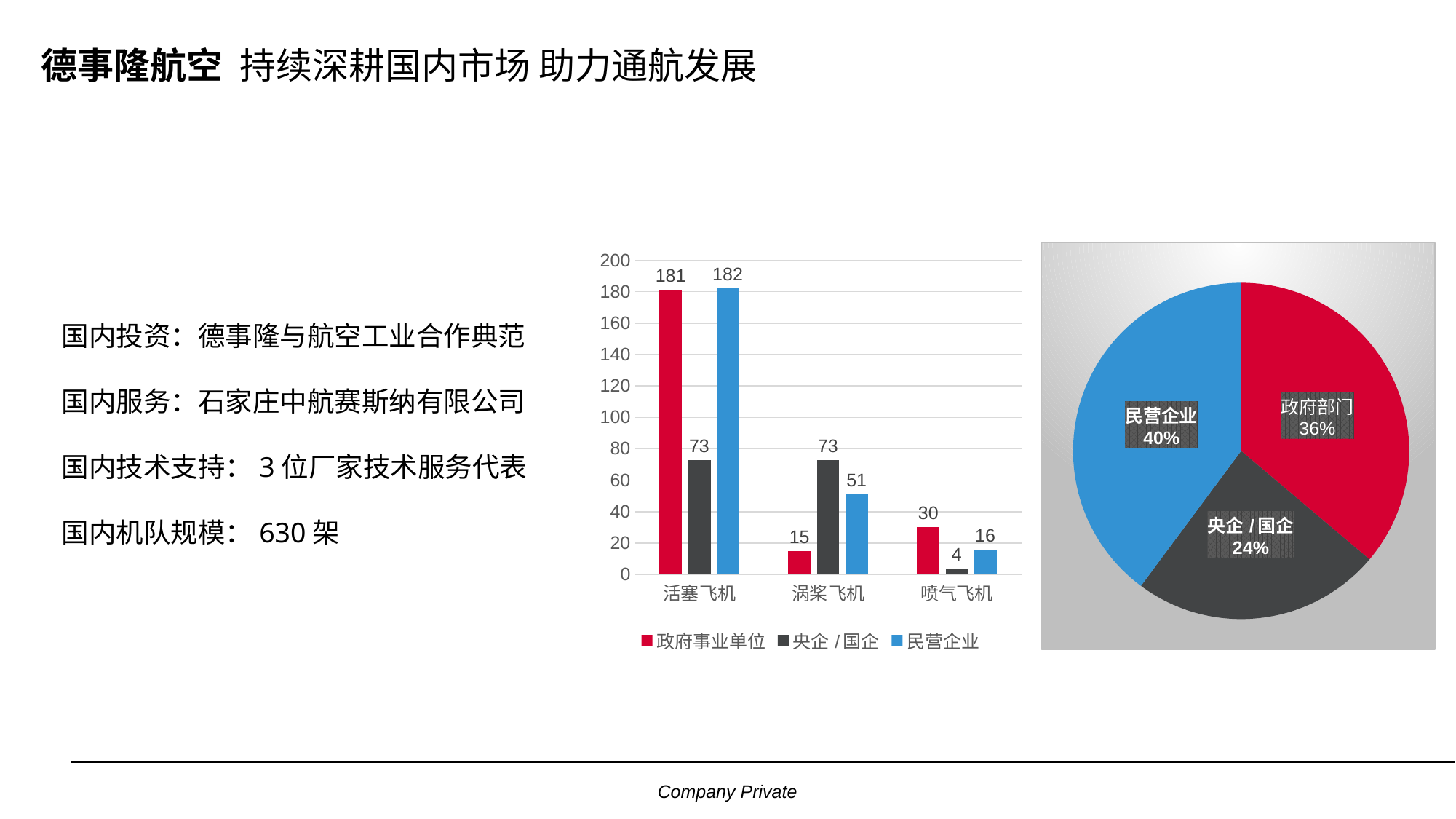
In the bar chart on the left, how many categories are shown on the x axis? 3 In the bar chart on the left, which is larger in the 涡桨飞机 category: 央企 / 国企 or 民营企业? 央企 / 国企 What kind of chart is the chart on the left? bar chart In the pie chart on the right, what colour is the 政府部门 slice? red In the bar chart on the left, what is the difference between the 民营企业 and 政府事业单位 values in the 涡桨飞机 category? 36 In the bar chart on the left, what is the value for 政府事业单位 in the 喷气飞机 category? 30 In the pie chart on the right, what share does 民营企业 have? 40% In the bar chart on the left, which series has the lowest value in the 喷气飞机 category? 央企 / 国企 In the bar chart on the left, how many series does the legend list? 3 In the pie chart on the right, which slice is the smallest? 央企 / 国企 In the bar chart on the left, what is the value for 央企 / 国企 in the 涡桨飞机 category? 73 In the bar chart on the left, what is the value for 民营企业 in the 活塞飞机 category? 182